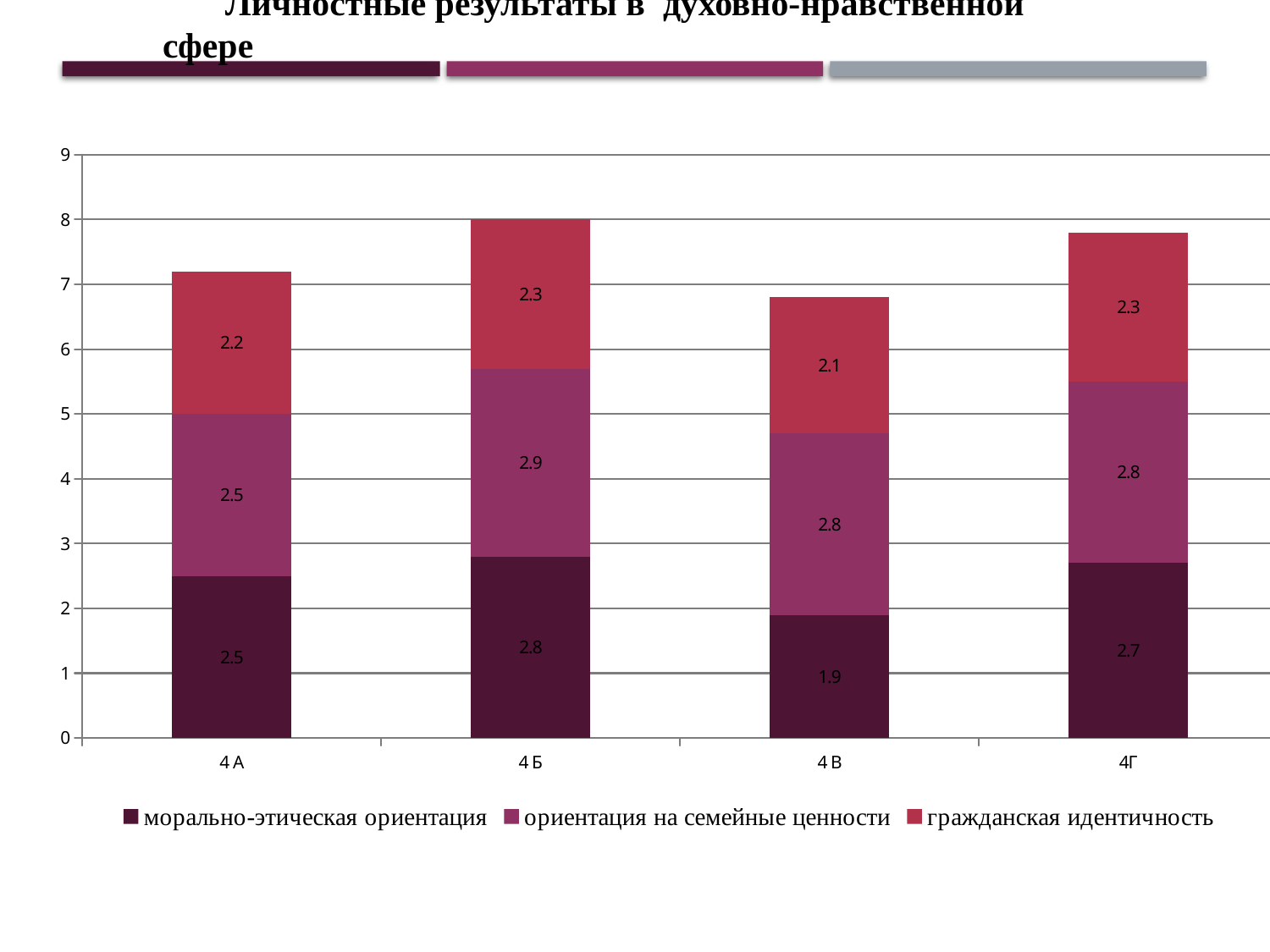
What is the total of the stacked bar for 4 Б? 8 Which is larger: гражданская идентичность for 4 А or for 4 Г? 4 Г How many categories are shown on the x axis? 4 How many series does the legend list? 3 Which category has the highest value for ориентация на семейные ценности? 4 Б What is the difference between the морально-этическая ориентация values for 4 Б and 4 В? 0.9 What is the total of the stacked bar for 4 В? 6.8 Which category has the lowest value for морально-этическая ориентация? 4 В What kind of chart is shown on the slide? Stacked bar chart What is the value of гражданская идентичность for 4 В? 2.1 What is the value of ориентация на семейные ценности for 4 Г? 2.8 What is the value of морально-этическая ориентация for 4 Б? 2.8